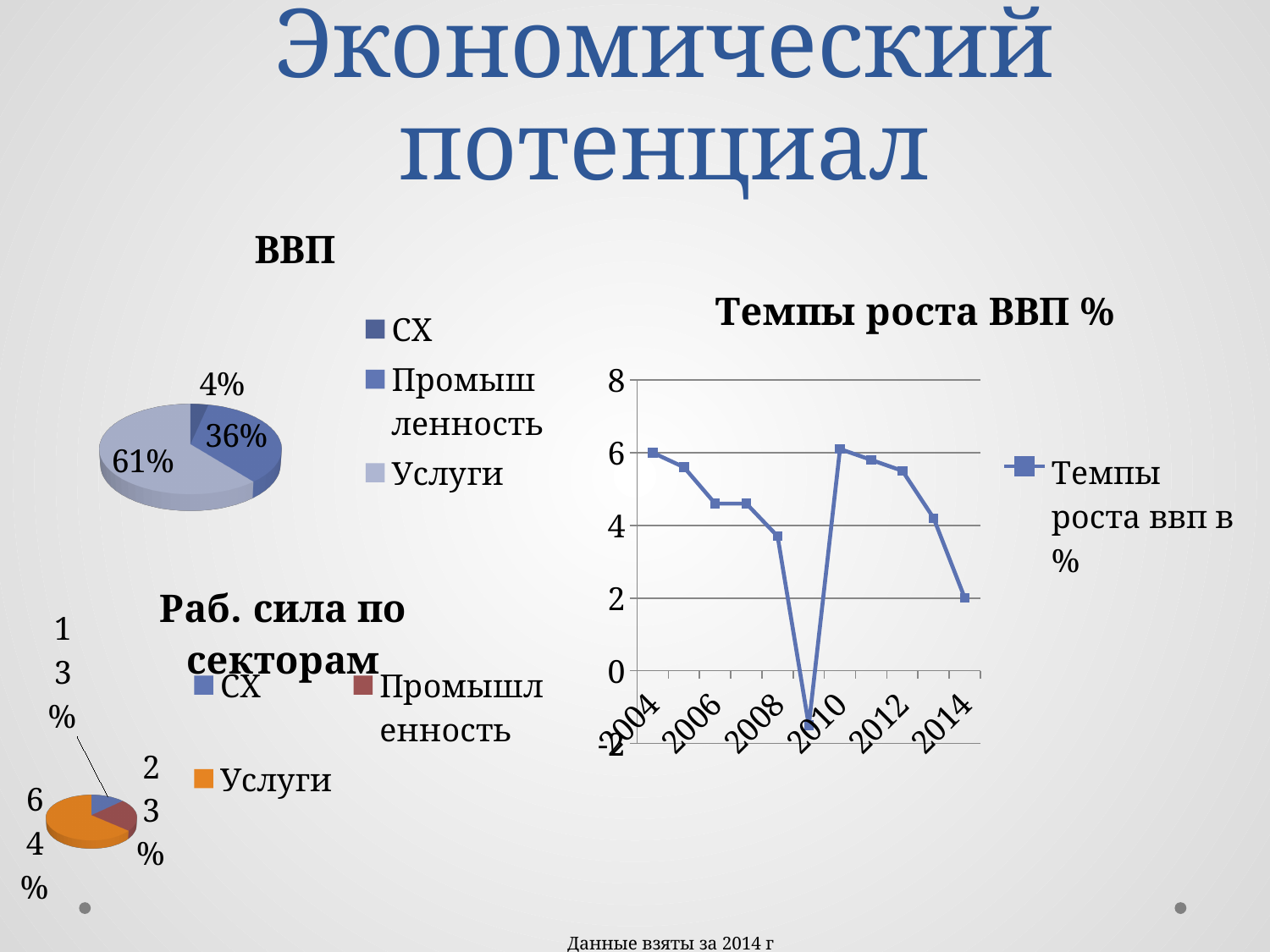
In the Темпы роста ВВП % chart, is the value for 2009 greater or less than 4? less In the ВВП pie chart, what share is labelled for Услуги? 61% What kind of chart is the Темпы роста ВВП % chart? line chart In the Раб. сила по секторам pie chart, what share is labelled for СХ? 13% In the Темпы роста ВВП % chart, how many data points are plotted? 11 In the Темпы роста ВВП % chart, do the values overall rise or fall from 2004 to 2014? fall In the Раб. сила по секторам pie chart, which is larger, the share for Промышленность or the share for СХ? Промышленность In the ВВП pie chart, what is the difference in percentage points between Услуги and Промышленность? 25 In the Темпы роста ВВП % chart, which year has the lowest value? 2009 In the ВВП pie chart, which sector has the smallest share? СХ In the Раб. сила по секторам pie chart, which sector has the largest share? Услуги In the ВВП pie chart, what share is labelled for Промышленность? 36%